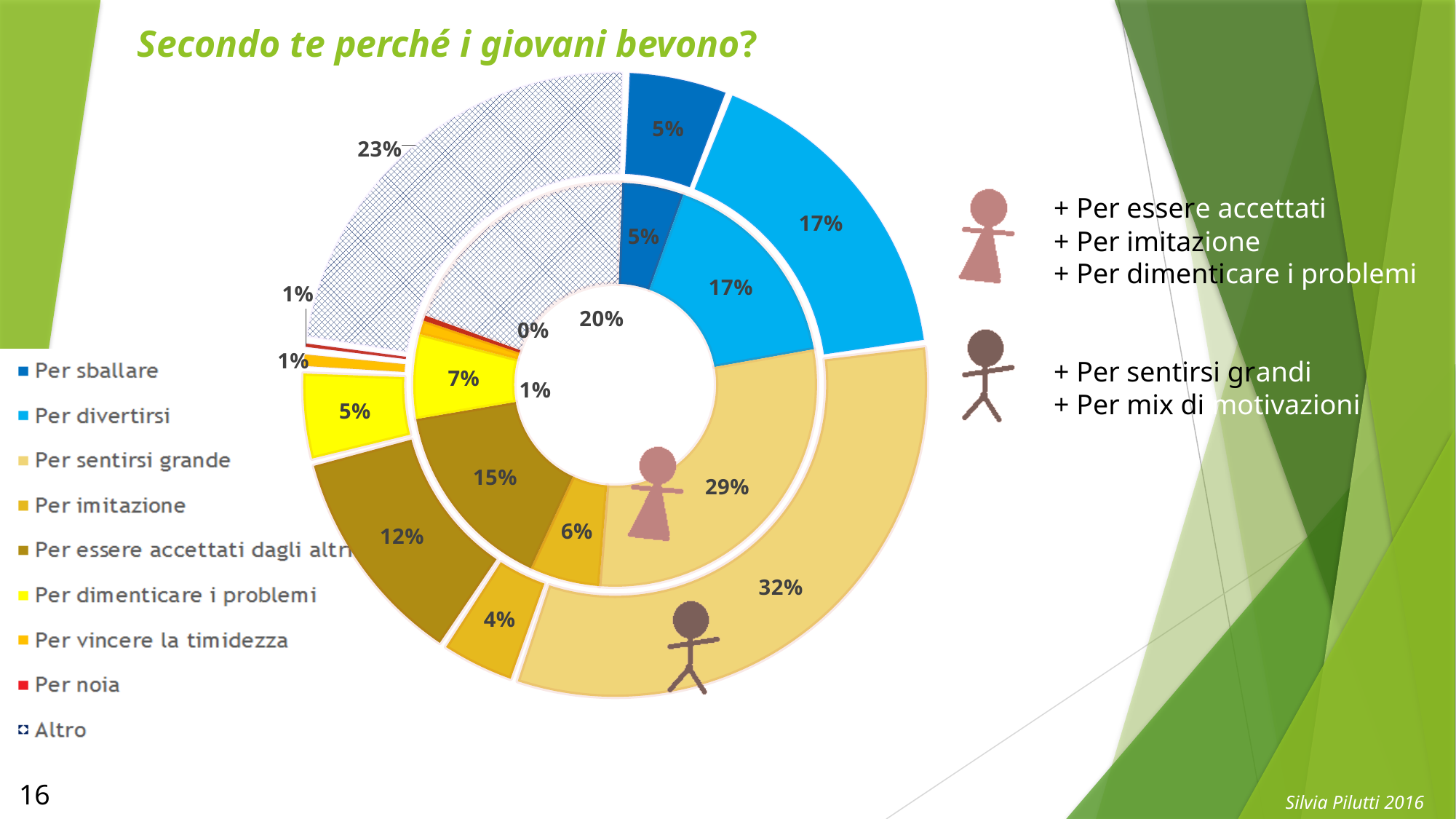
What is the difference between 'Per sentirsi grande' in the outer ring and in the inner ring? 3% What is the value for 'Per essere accettati dagli altri' in the inner ring? 15% Which is larger in the inner ring: 'Per essere accettati dagli altri' or 'Per imitazione'? Per essere accettati dagli altri What is the value for 'Per noia' in the outer ring? 1% What is the value for 'Per divertirsi' in the outer ring? 17% What is the value for 'Per sentirsi grande' in the outer ring? 32% Which category has the largest share in the outer ring? Per sentirsi grande What kind of chart is shown on the slide? doughnut chart How many categories does the legend list? 9 What is the value for 'Per sentirsi grande' in the inner ring? 29% What is the value for 'Altro' in the inner ring? 20% What is the value for 'Altro' in the outer ring? 23%